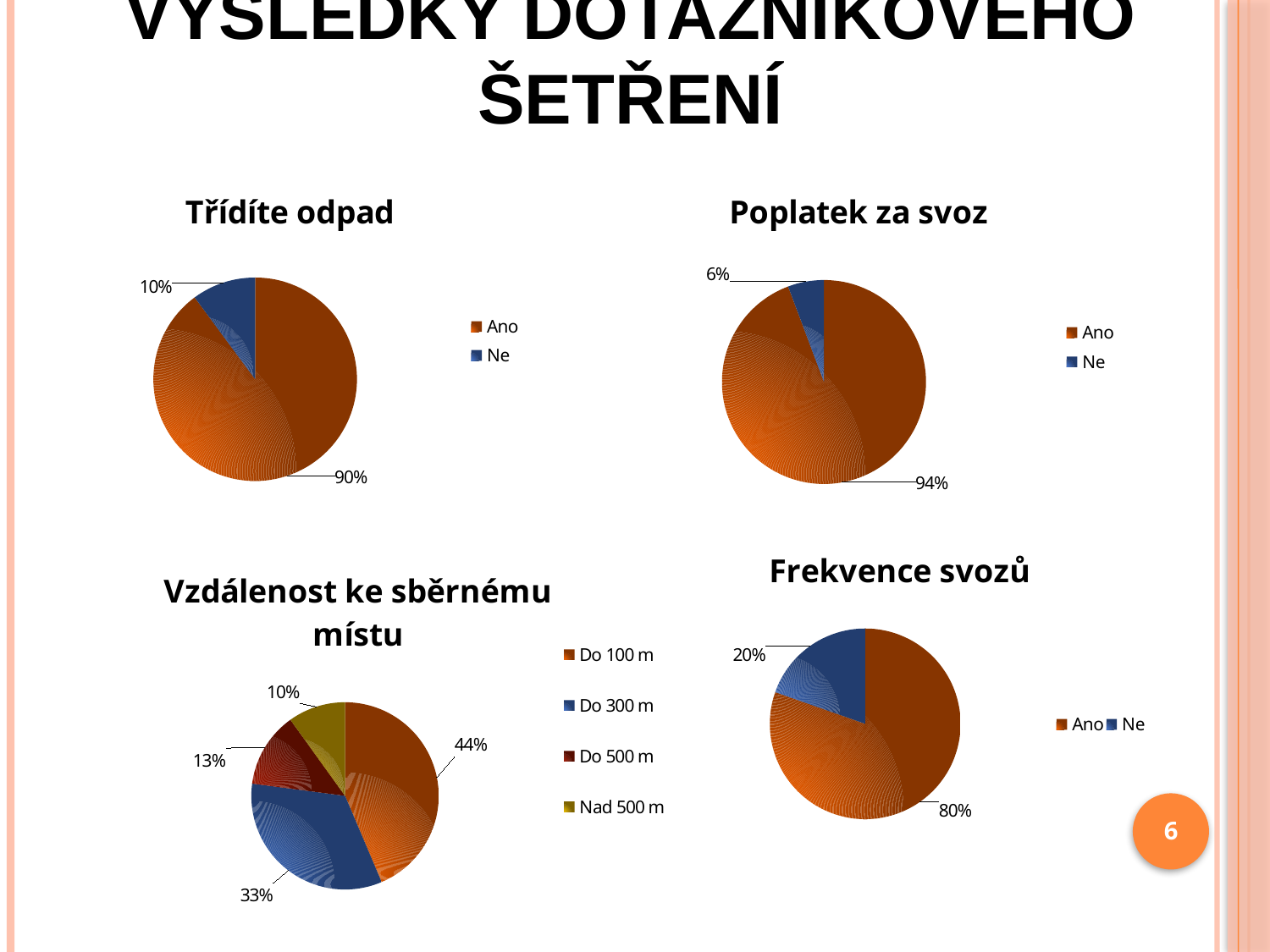
In the "Poplatek za svoz" chart, what is the value for "Ano"? 94% In the "Vzdálenost ke sběrnému místu" chart, which category is the smallest? Nad 500 m What kind of chart is "Frekvence svozů"? Pie chart In the "Poplatek za svoz" chart, what is the difference between "Ano" and "Ne"? 88% In the "Vzdálenost ke sběrnému místu" chart, what is the value for "Do 300 m"? 33% In the "Frekvence svozů" chart, which is larger, "Ano" or "Ne"? Ano In the "Frekvence svozů" chart, what is the value for "Ne"? 20% In the "Vzdálenost ke sběrnému místu" chart, how many categories does the legend list? 4 In the "Třídíte odpad" chart, what share of the pie is "Ano"? 90% In the "Třídíte odpad" chart, what is the value for "Ne"? 10% In the "Vzdálenost ke sběrnému místu" chart, which category is the largest? Do 100 m How many charts are shown on the slide? 4